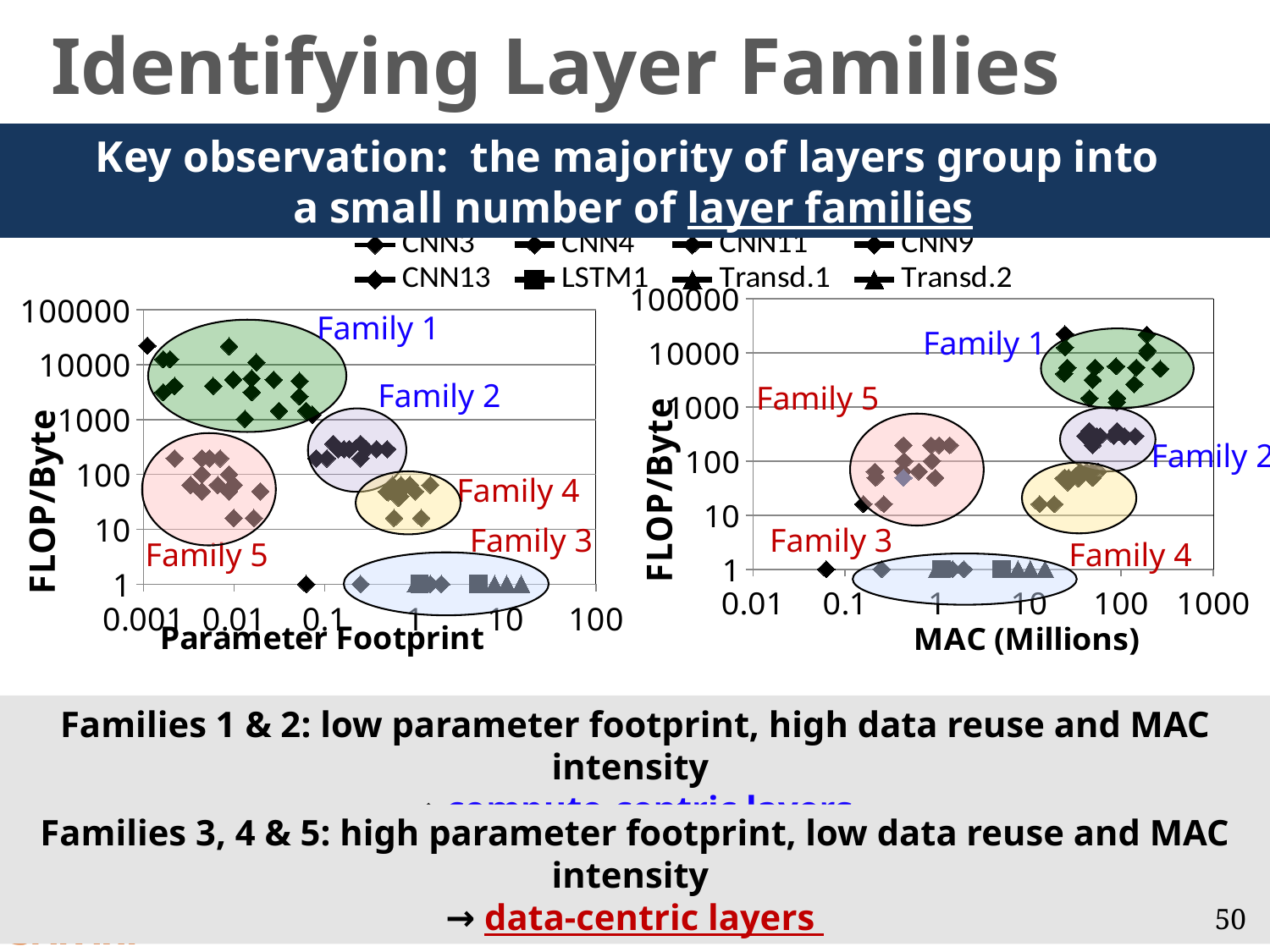
On the left chart, are the FLOP/Byte values of the Family 4 points greater or less than 100? less On the left chart, which family has higher FLOP/Byte values, Family 1 or Family 3? Family 1 On the right chart, are the FLOP/Byte values of the Family 3 points greater or less than 10? less How many series does the shared legend list for the charts? 8 On the left chart, are the FLOP/Byte values of the Family 2 points greater or less than 100? greater How many layer families are annotated on the left chart? 5 What is the x-axis label of the left chart? Parameter Footprint What kind of chart is the left chart (FLOP/Byte vs Parameter Footprint)? scatter chart What kind of chart is the right chart (FLOP/Byte vs MAC (Millions))? scatter chart What is the x-axis label of the right chart? MAC (Millions)